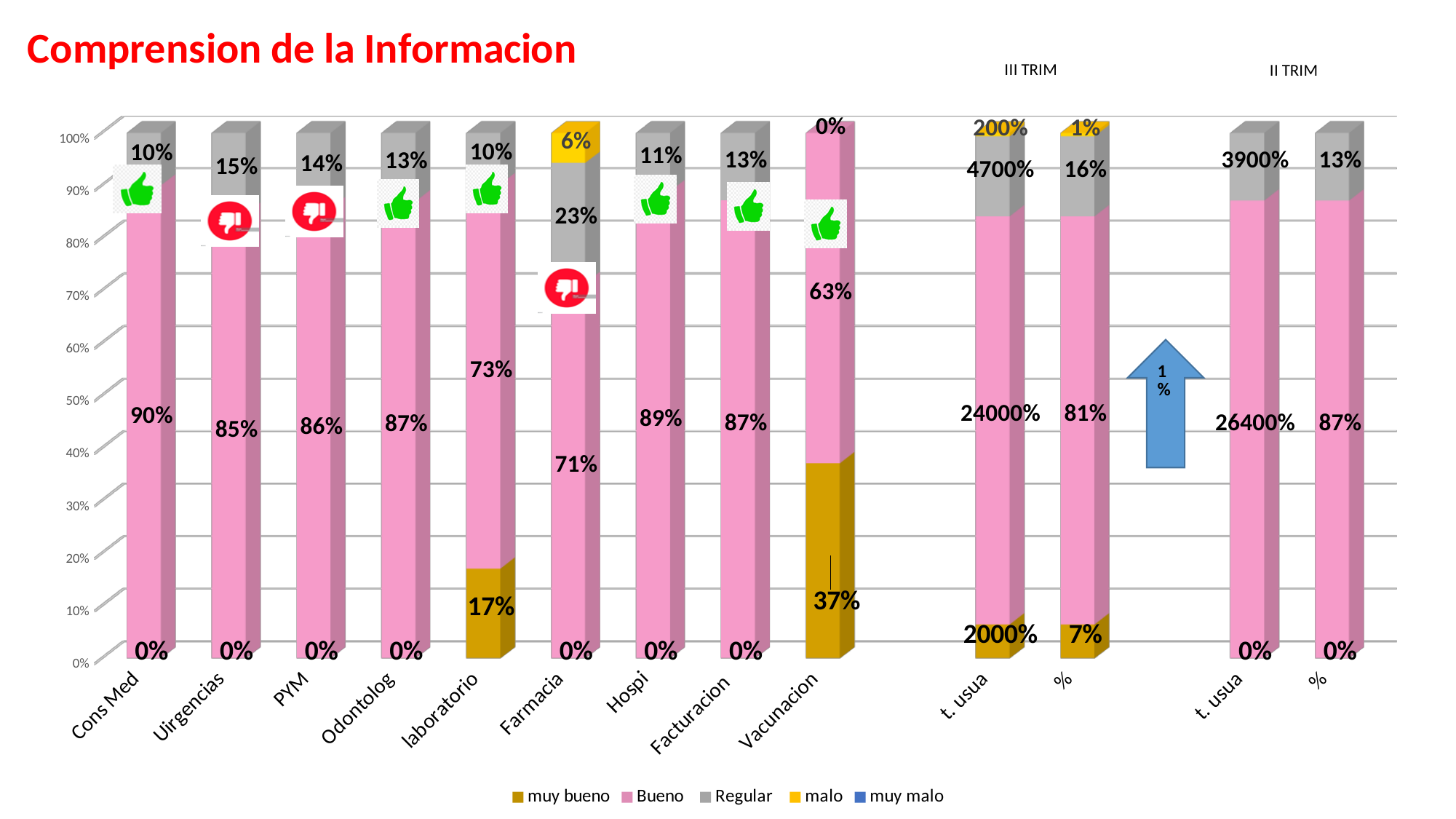
What kind of chart is shown on the slide? stacked bar chart Which has a larger Bueno value, Hospi or Odontolog? Hospi How many series does the legend list? 5 What is the difference between the Bueno values for Cons Med and Uirgencias? 5% What is the malo value for Farmacia? 6% What is the muy bueno value for laboratorio? 17% What is the Regular value for Farmacia? 23% What is the muy bueno value for Vacunacion? 37% Which of the first nine service categories has the lowest Bueno value? Vacunacion What is the Bueno value for the II TRIM '%' bar? 87% Which of the first nine service categories has the highest Regular value? Farmacia What is the Bueno value for Cons Med? 90%